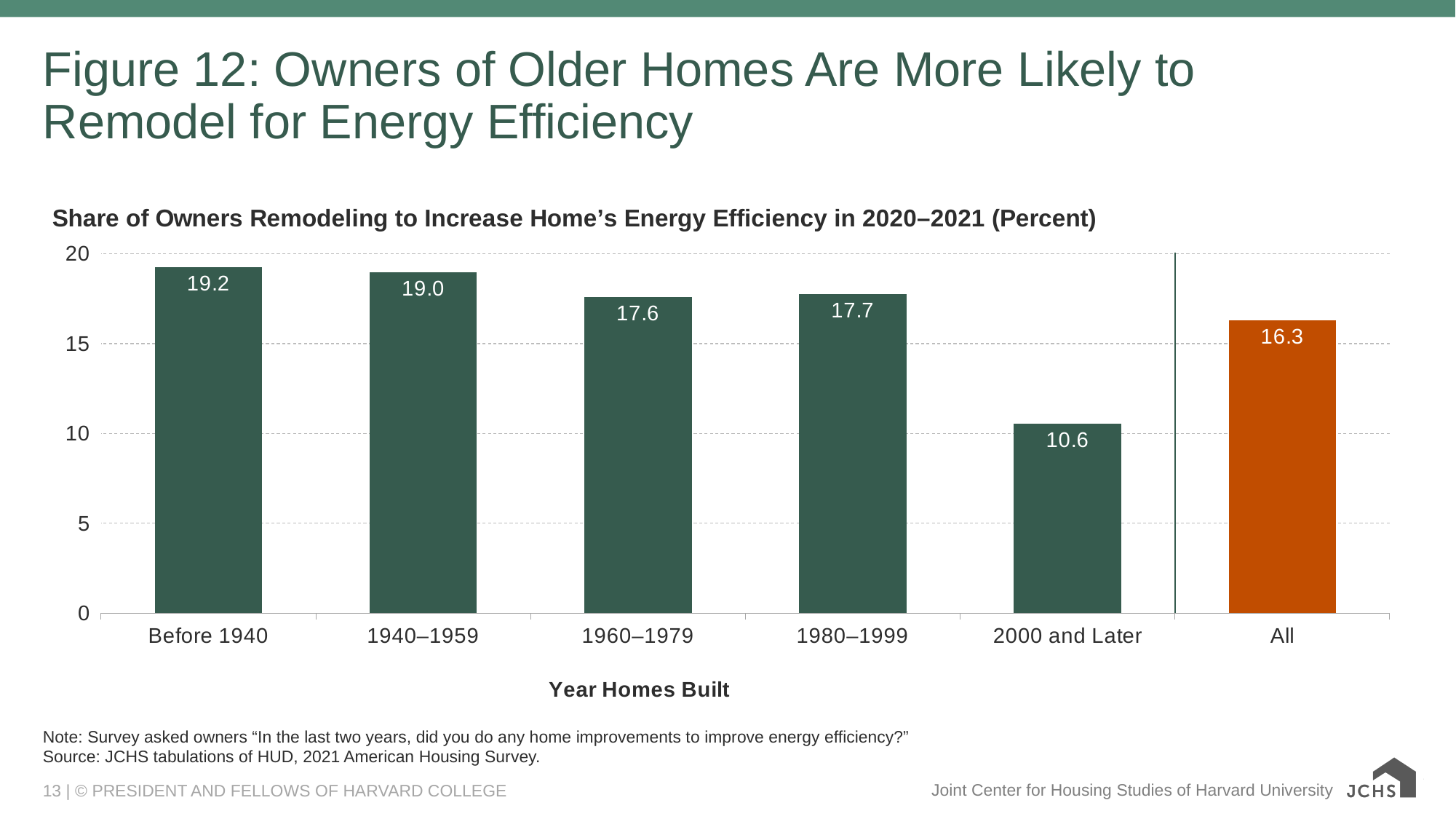
What is the value for the All category? 16.3 Which is larger, the value for 1960–1979 or the value for 1980–1999? 1980–1999 What is the label of the x axis? Year Homes Built How many bars are shown in the chart? 6 What is the value for homes built 2000 and Later? 10.6 Which year-built category has the highest share of owners remodeling for energy efficiency? Before 1940 What kind of chart is shown on the slide? Bar chart Which year-built category has the lowest share of owners remodeling for energy efficiency? 2000 and Later Is the value for 2000 and Later greater or less than 15? less What is the difference between the values for 1940–1959 and All? 2.7 What is the difference between the values for Before 1940 and 2000 and Later? 8.6 What is the share of owners remodeling for energy efficiency for homes built before 1940? 19.2